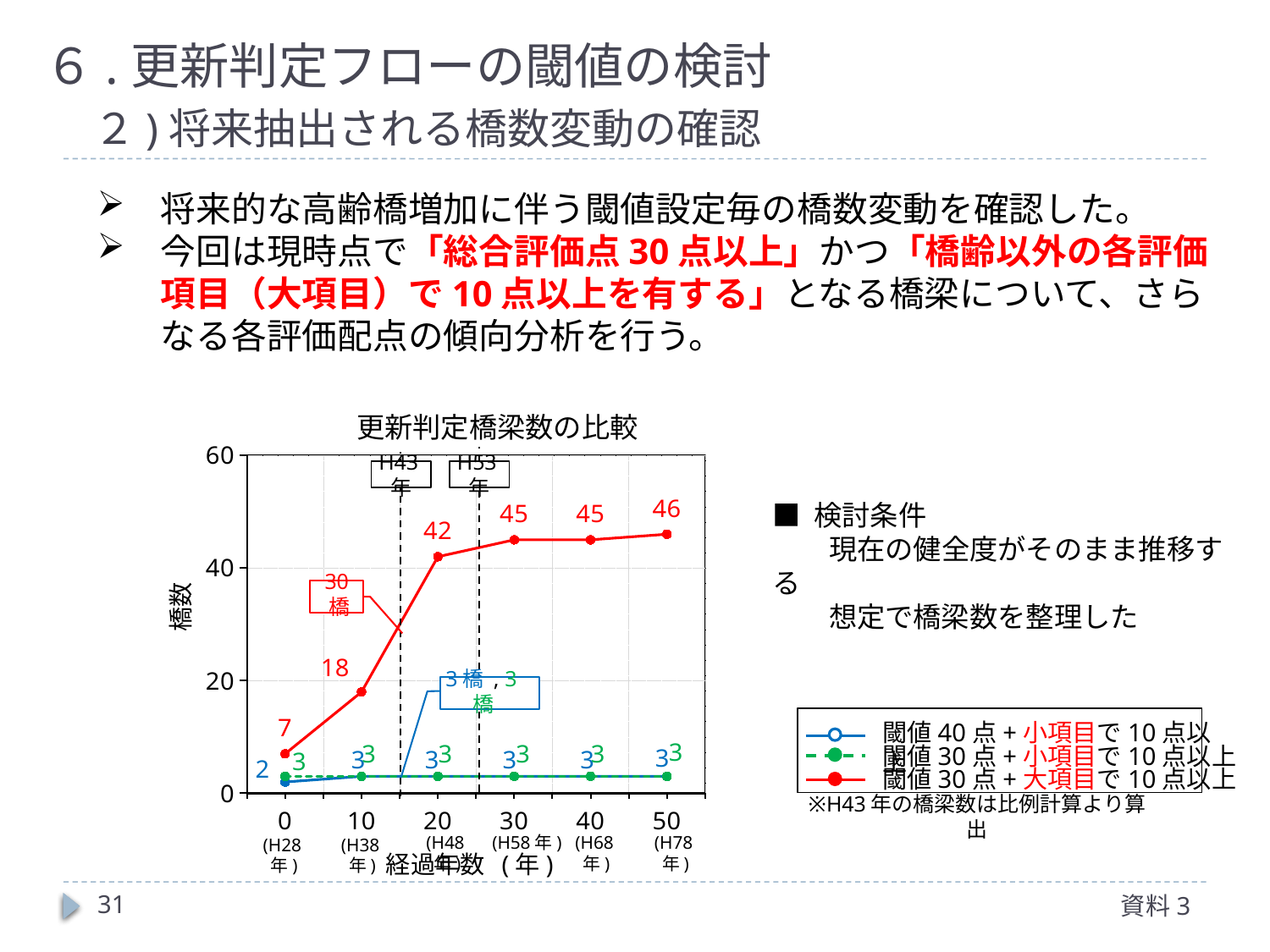
At which 経過年数 does the 閾値30点+大項目で10点以上 series reach its highest value? 50 What is the difference between the 閾値30点+大項目で10点以上 values at 経過年数 20 and 経過年数 10? 24 How many series does the chart legend list? 3 Does the 閾値30点+大項目で10点以上 series rise or fall as 経過年数 increases from 0 to 50? rise What is the value of the 閾値30点+大項目で10点以上 series at 経過年数 20? 42 How many data points are plotted along the x axis for each series? 6 What is the value of the 閾値30点+大項目で10点以上 series at 経過年数 0? 7 What is the title of the chart? 更新判定橋梁数の比較 What is the value of the 閾値30点+大項目で10点以上 series at 経過年数 10? 18 What is the value of the 閾値40点+小項目で10点以上 series at 経過年数 0? 2 What is the value of the 閾値30点+大項目で10点以上 series at 経過年数 50? 46 What type of chart is shown on the slide? line chart